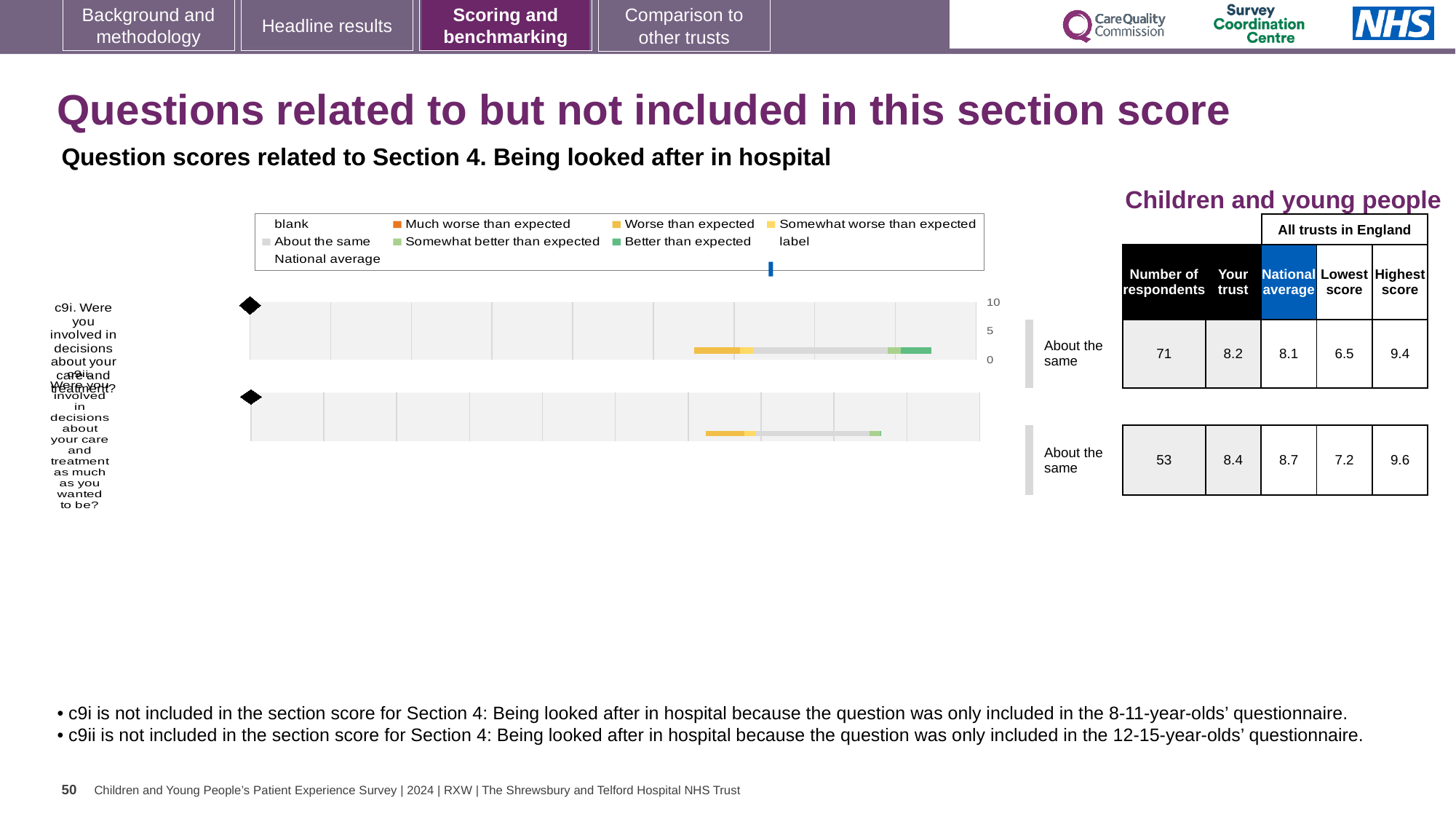
What is the national average score for question c9i? 8.1 Which question has the higher 'Your trust' score, c9i or c9ii? c9ii What is the lowest score among all trusts in England for question c9ii? 7.2 What colour represents 'Better than expected' in the chart legend? green What type of chart is used to show the question scores for c9i and c9ii? bar chart What is the difference between the highest score and the lowest score for question c9i? 2.9 How many questions (bars) are plotted in the chart? 2 By how much does the national average exceed the 'Your trust' score for question c9ii? 0.3 What is the 'Your trust' score for question c9ii? 8.4 What is the number of respondents for question c9i? 71 Which question has more respondents, c9i or c9ii? c9i What benchmark category is shown next to the bar for question c9i? About the same